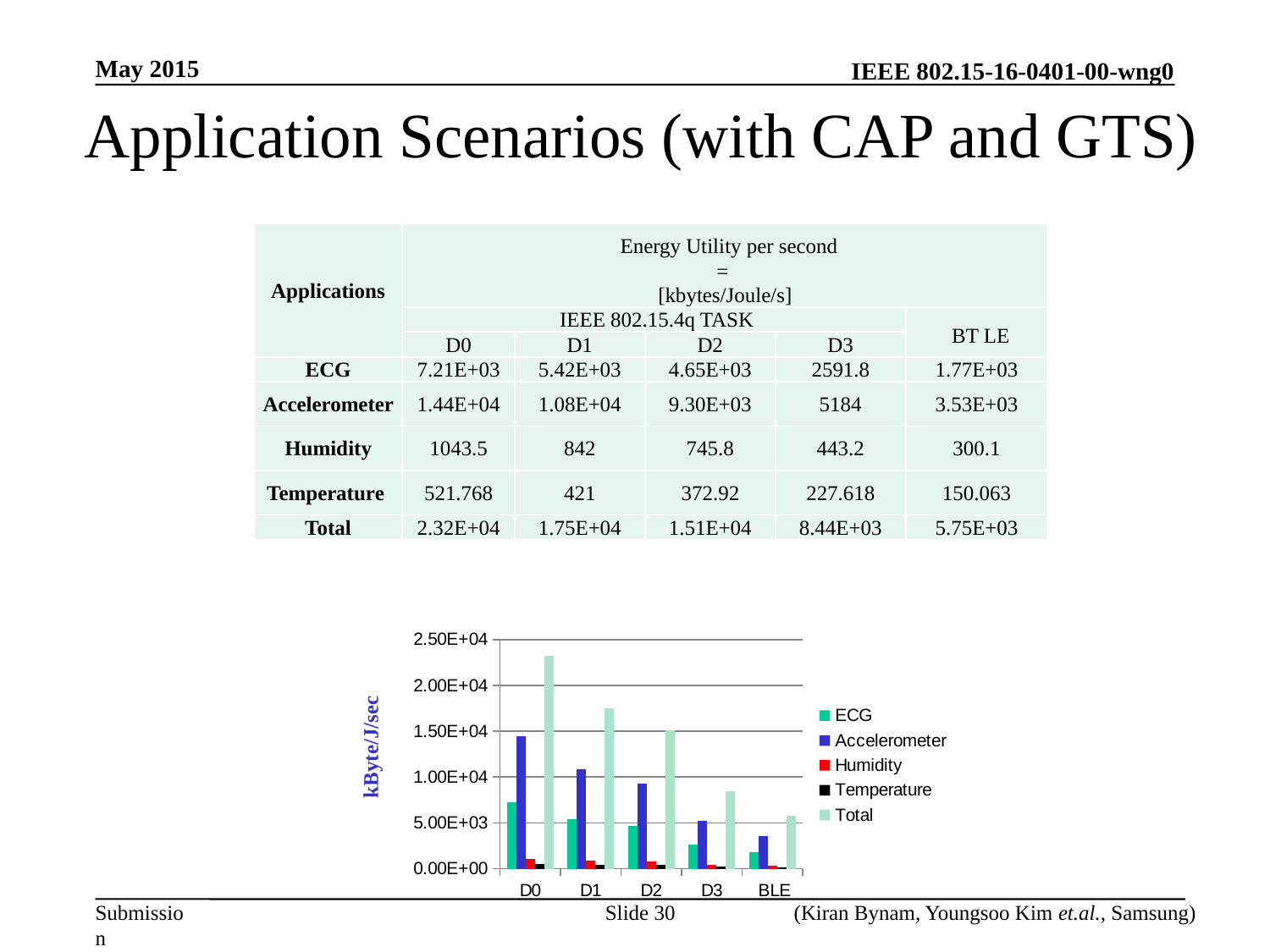
Is the Total value for D0 greater or less than 2.00E+04? greater How many series does the chart legend list? 5 What is the label on the y axis of the chart? kByte/J/sec Is the Accelerometer value for D1 greater or less than 1.00E+04? greater At D0, which is larger: the ECG bar or the Accelerometer bar? Accelerometer Which category has the lowest Total bar in the chart? BLE Is the Accelerometer value for BLE greater or less than 5.00E+03? less How many categories are shown on the x axis of the chart? 5 Which category has the highest Total bar in the chart? D0 Do the Total values rise or fall from D0 to BLE along the x axis? fall What kind of chart is shown on the slide? bar chart